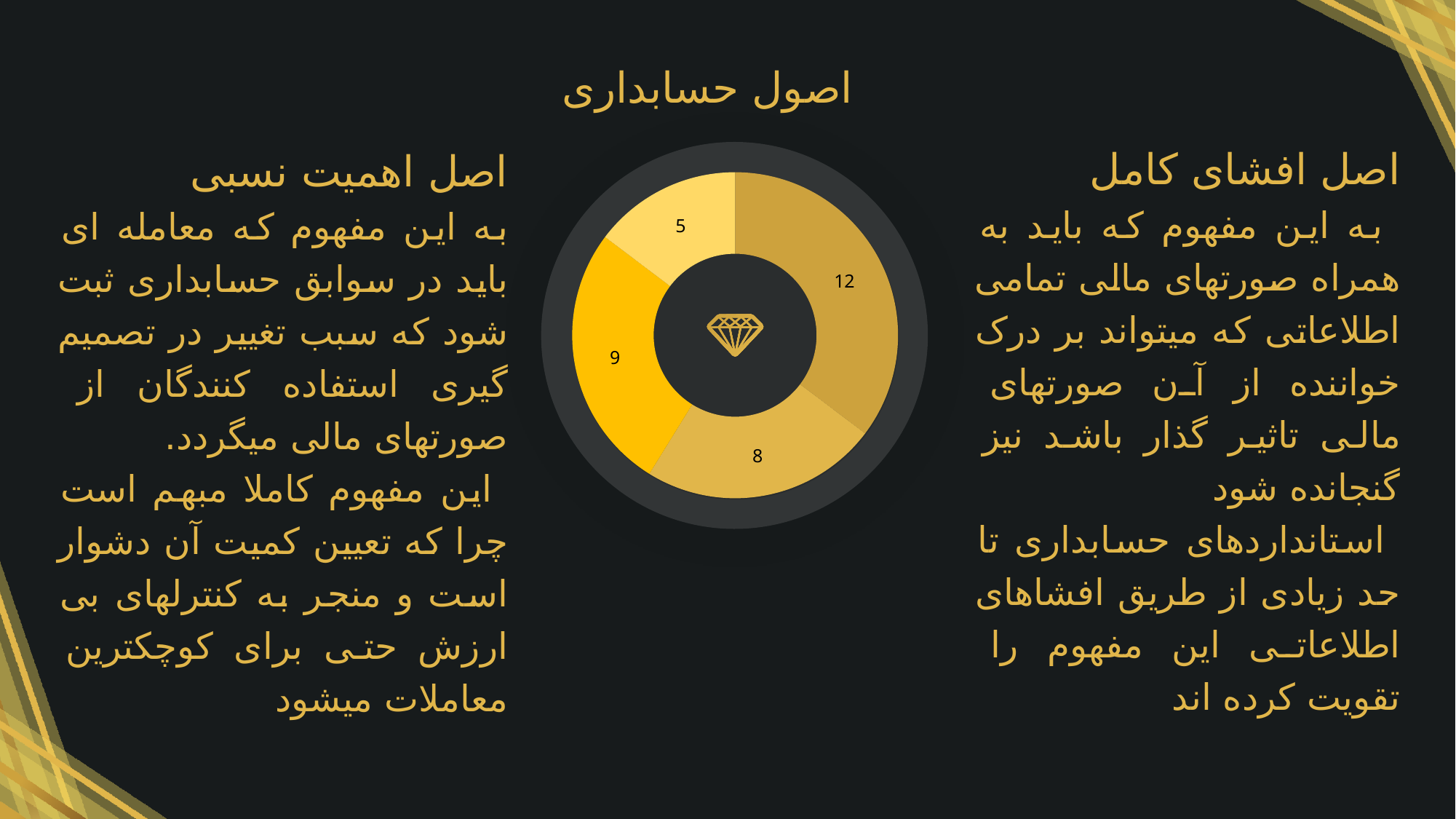
What is the largest value shown on the doughnut chart? 12 What is the difference between the slice labelled 12 and the slice labelled 8? 4 Which is larger on the doughnut chart, the slice labelled 9 or the slice labelled 8? 9 What icon appears in the centre of the doughnut chart? A diamond What is the smallest value shown on the doughnut chart? 5 What value is printed on the slice at the bottom of the doughnut chart? 8 Does the doughnut chart have a legend? No What is the difference between the largest and smallest values on the doughnut chart? 7 What kind of chart is shown in the centre of the slide? Doughnut (pie) chart What value is printed on the slice at the top-left of the doughnut chart? 5 How many slices does the doughnut chart have? 4 What is the total of all the values shown on the doughnut chart? 34